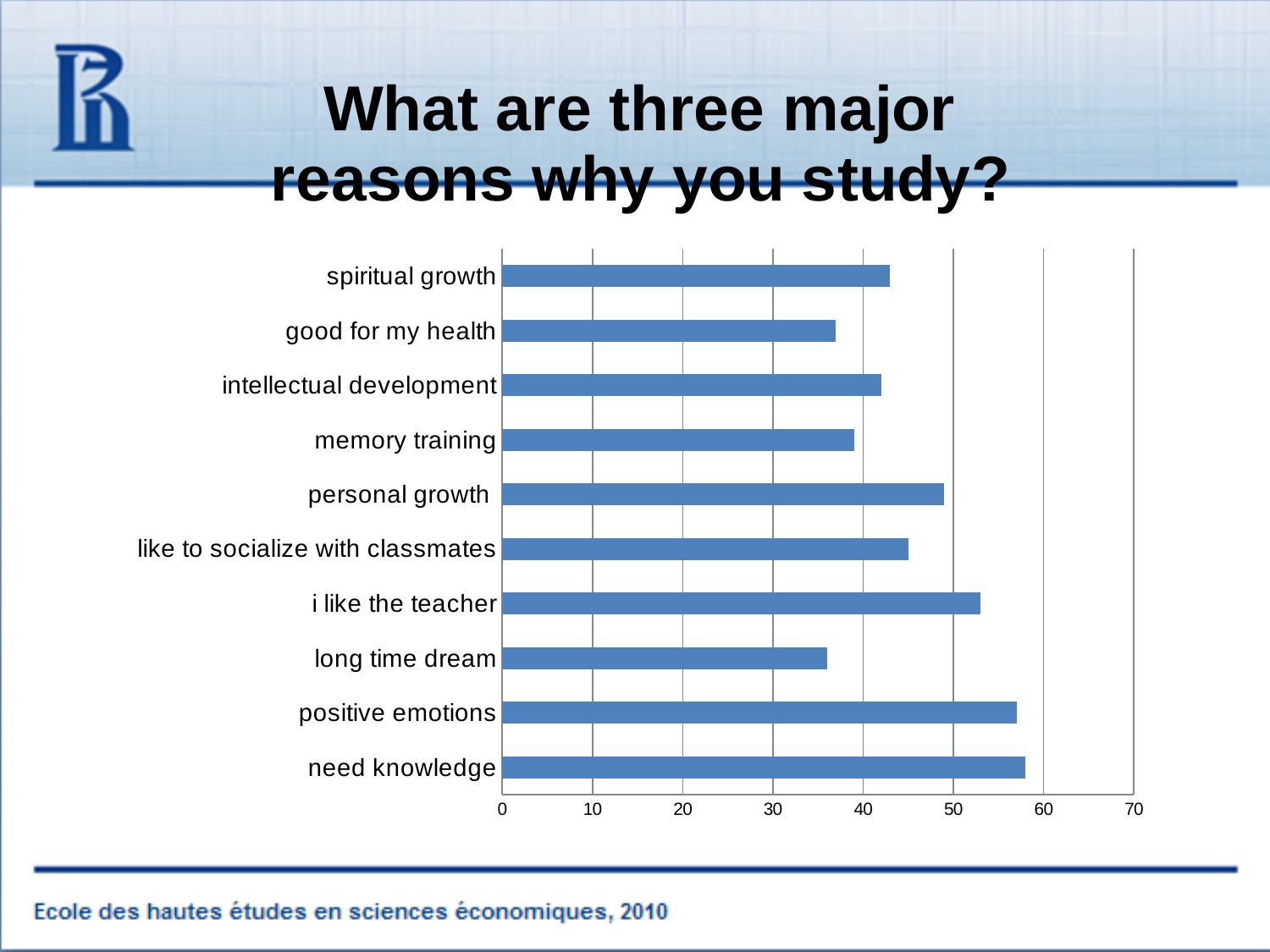
Is the value for "personal growth" greater or less than 40? greater Is the value for "need knowledge" greater or less than 50? greater Is the value for "good for my health" greater or less than 40? less Which has the larger value: "long time dream" or "personal growth"? personal growth What is the title of the slide containing the chart? What are three major reasons why you study? How many reasons (categories) are listed on the chart? 10 Which has the larger value: "i like the teacher" or "personal growth"? i like the teacher Which has the larger value: "positive emotions" or "spiritual growth"? positive emotions What kind of chart is shown on the slide? bar chart